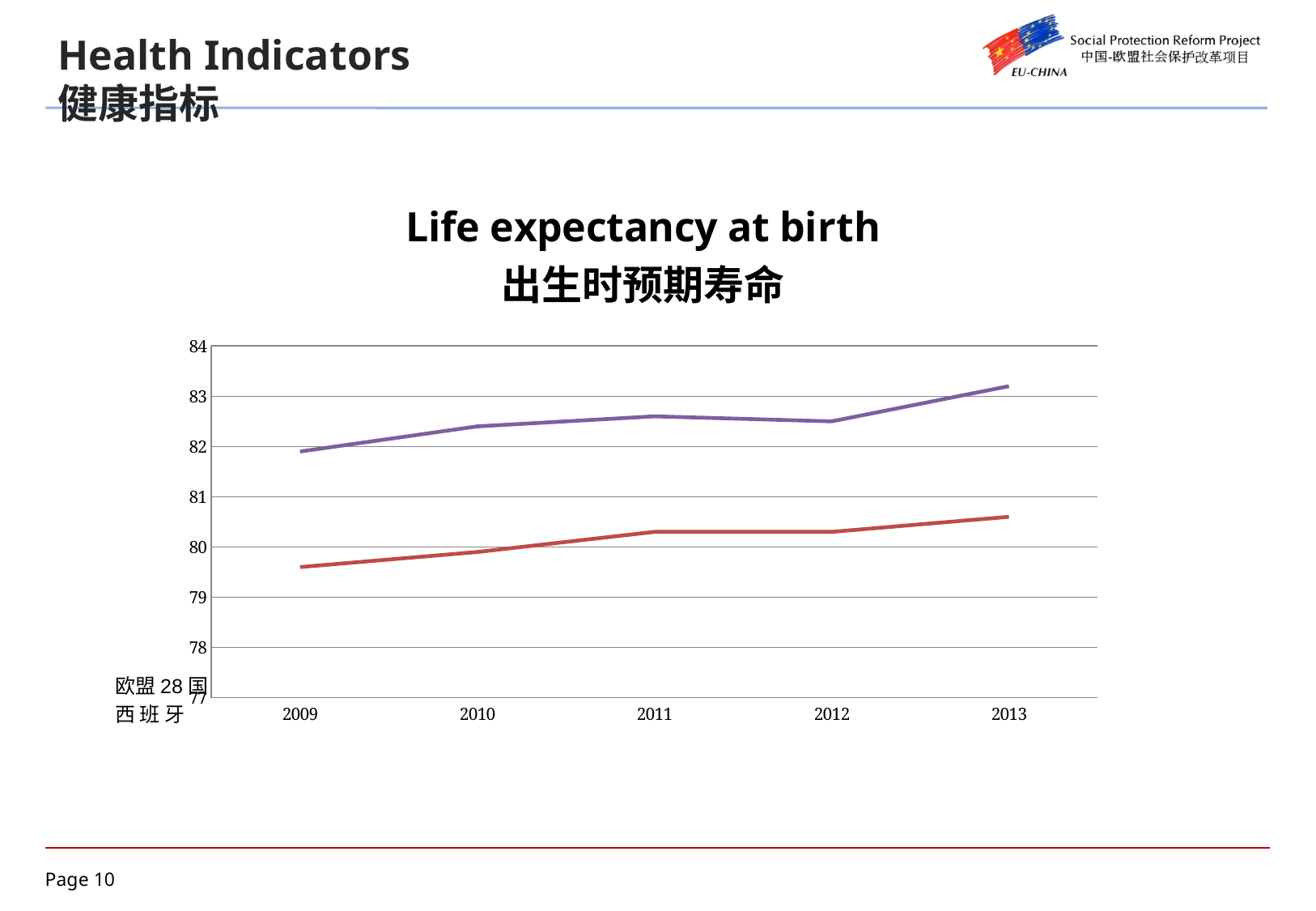
Is the value of the red line in 2013 greater or less than 80? greater Does the red line rise or fall overall from 2009 to 2013? rise Is the value of the purple line in 2012 greater or less than 83? less What kind of chart is shown on the slide? line chart How many years are shown on the x axis of the chart? 5 Is the value of the red line in 2012 greater or less than 81? less Does the purple line rise or fall overall from 2009 to 2013? rise In 2013, which line has the higher value, the purple line or the red line? the purple line In which year does the purple line reach its highest value? 2013 What is the title of the chart? Life expectancy at birth 出生时预期寿命